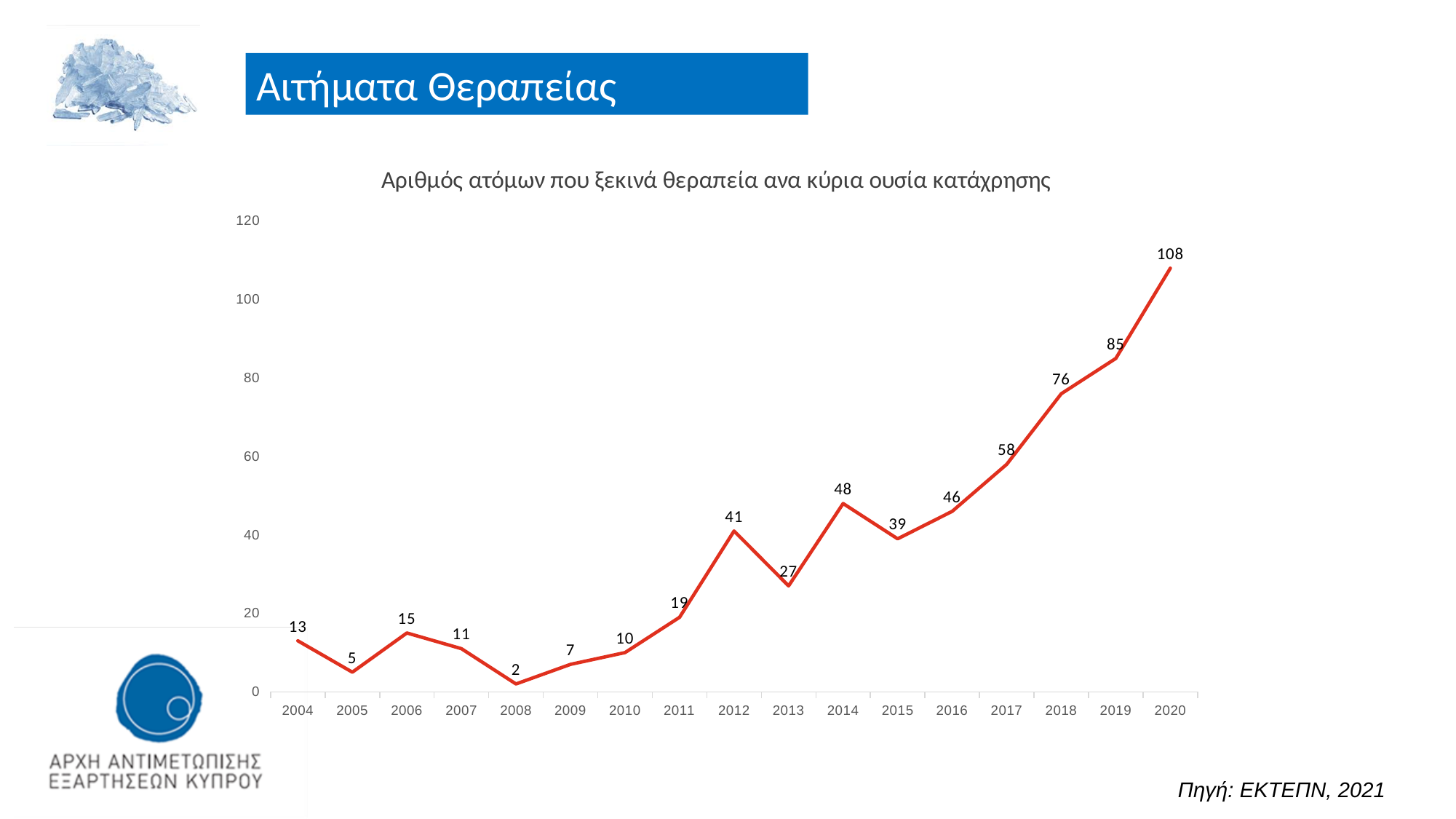
Is the value for 2018 greater or less than 60? greater What is the value for 2020? 108 How many years are plotted on the x axis? 17 What is the difference between the values for 2020 and 2019? 23 Which year has the highest value? 2020 Which year has the lowest value? 2008 Which is larger, the value for 2012 or the value for 2014? 2014 Do the values generally rise or fall from 2015 to 2020? rise What is the value for 2008? 2 What is the title of the chart? Αριθμός ατόμων που ξεκινά θεραπεία ανα κύρια ουσία κατάχρησης What kind of chart is shown on the slide? line chart What is the value for 2013? 27